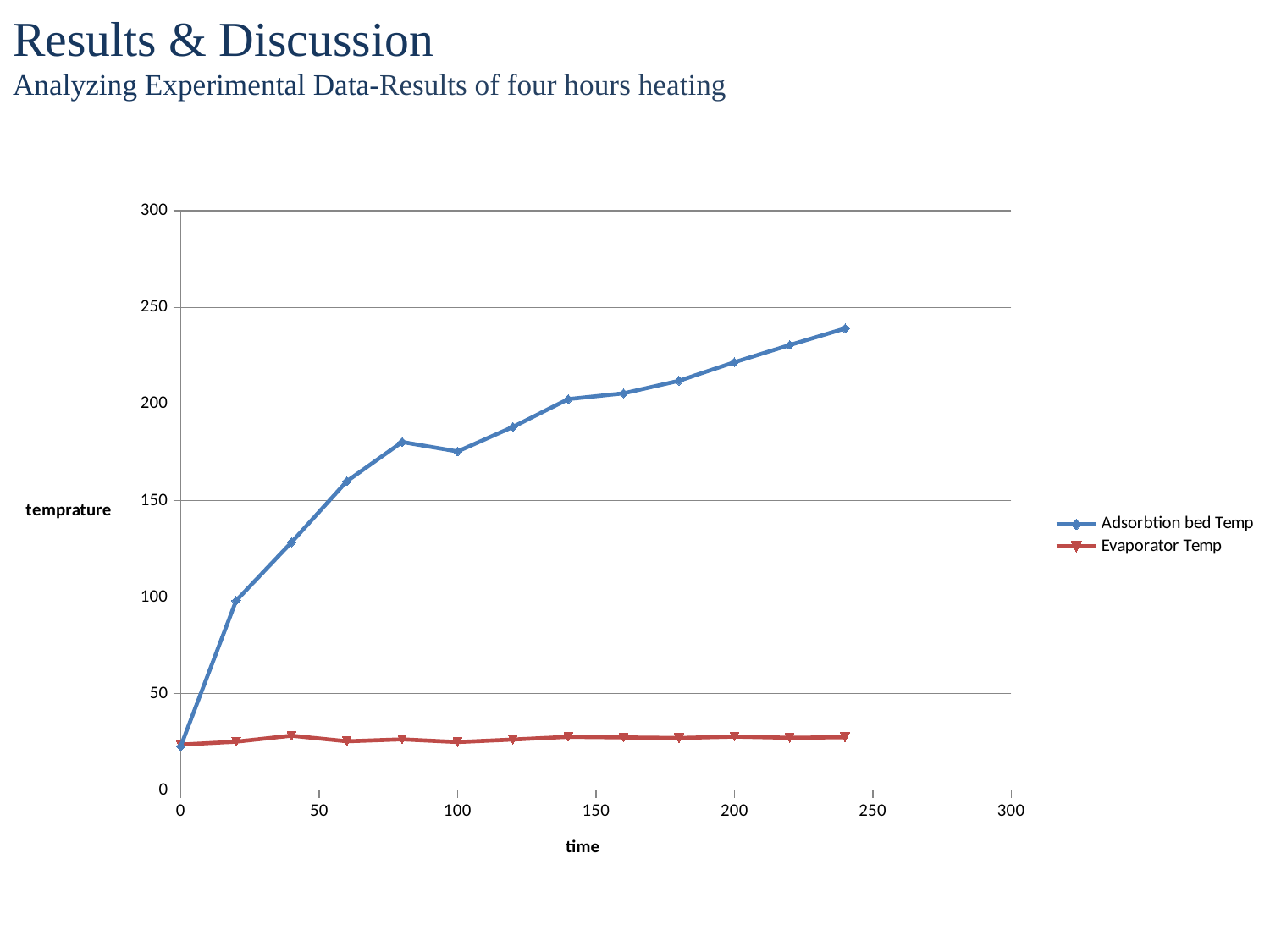
Does the Adsorbtion bed Temp series rise or fall overall as time increases? rise Is the Adsorbtion bed Temp value at time 100 greater or less than 150? greater Is the Adsorbtion bed Temp value at time 40 greater or less than 100? greater At which time does the Adsorbtion bed Temp series reach its highest value? 240 At time 200, which series has the higher value, Adsorbtion bed Temp or Evaporator Temp? Adsorbtion bed Temp Is the Adsorbtion bed Temp value at time 240 greater or less than 200? greater How many series does the legend list? 2 What is the label of the x axis? time What is the label of the y axis? temprature What kind of chart is shown on the slide? line chart How many data points are plotted for the Adsorbtion bed Temp series? 13